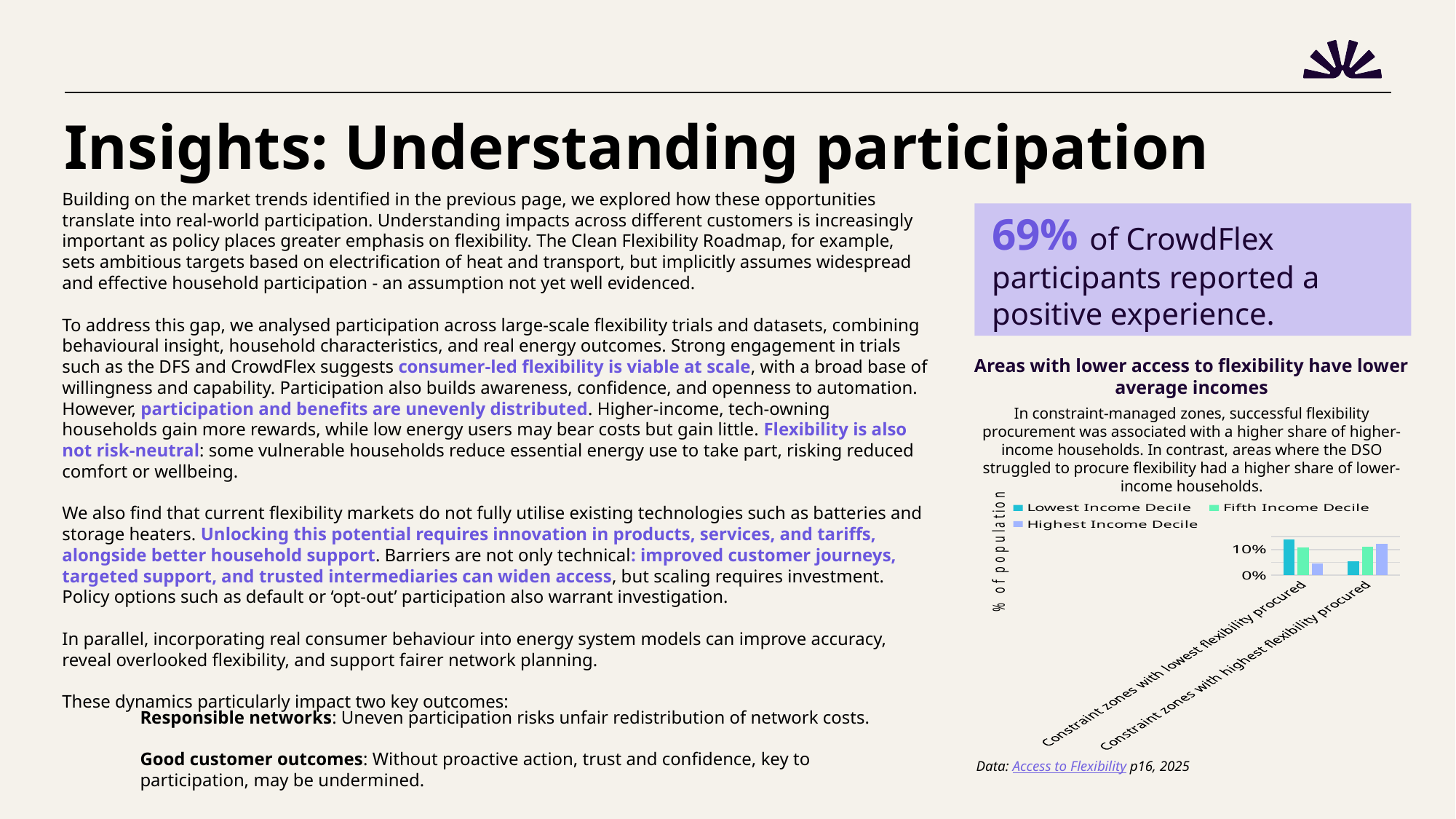
Which series has the shortest bar for 'Constraint zones with highest flexibility procured'? Lowest Income Decile Which series has the shortest bar for 'Constraint zones with lowest flexibility procured'? Highest Income Decile For the Lowest Income Decile series, which category has the larger value: 'Constraint zones with lowest flexibility procured' or 'Constraint zones with highest flexibility procured'? Constraint zones with lowest flexibility procured Which series has the tallest bar for 'Constraint zones with lowest flexibility procured'? Lowest Income Decile For the Highest Income Decile series, which category has the larger value: 'Constraint zones with lowest flexibility procured' or 'Constraint zones with highest flexibility procured'? Constraint zones with highest flexibility procured Is the value for Lowest Income Decile in 'Constraint zones with highest flexibility procured' greater or less than 10%? less How many categories are shown on the x axis of the chart? 2 What is the title of the chart? Areas with lower access to flexibility have lower average incomes What is the label on the y axis of the chart? % of population What kind of chart is shown on the slide? bar chart Is the value for Highest Income Decile in 'Constraint zones with lowest flexibility procured' greater or less than 10%? less How many series does the chart legend list? 3